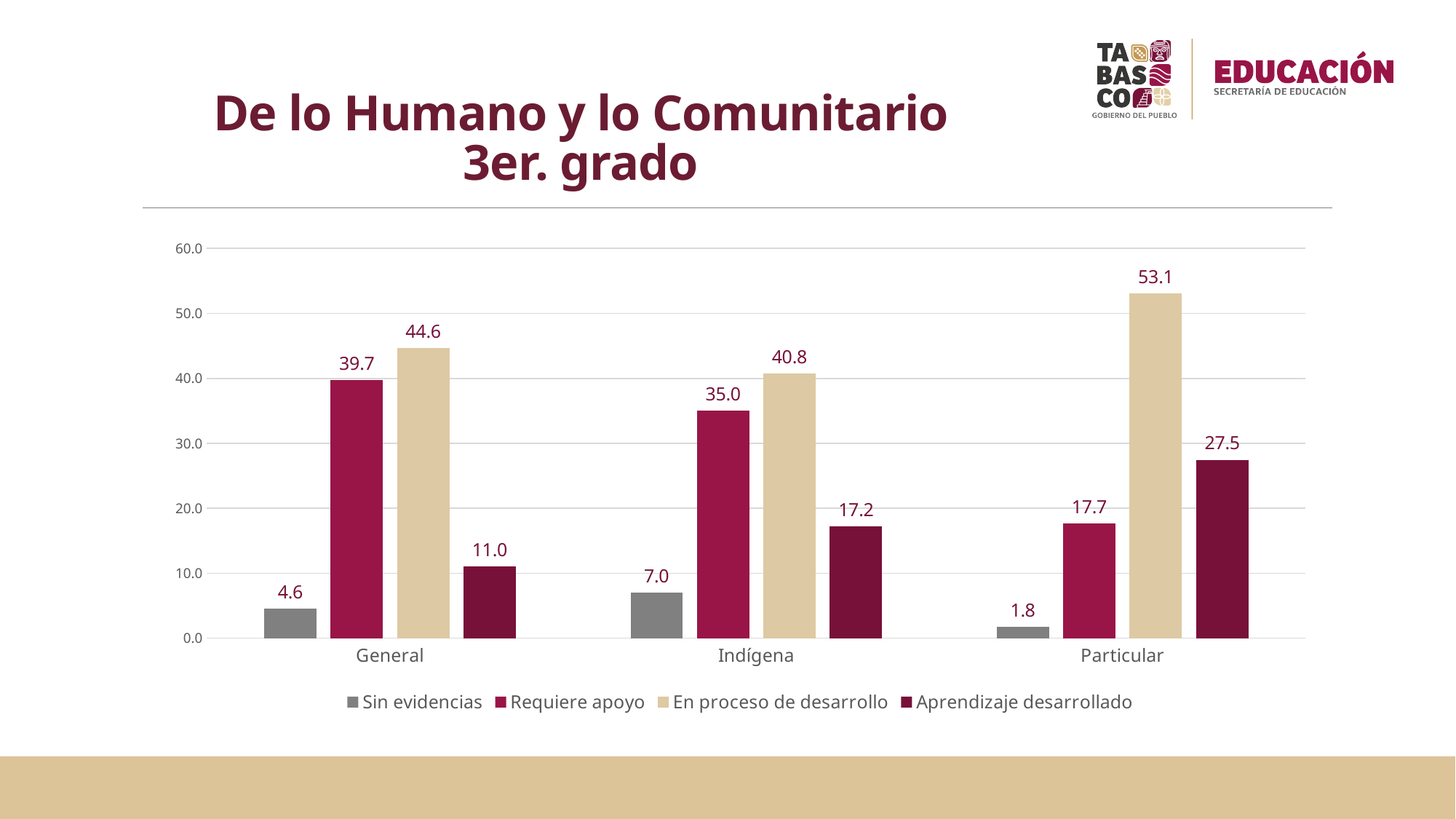
Which category has the highest value for "Requiere apoyo"? General Is the value for "En proceso de desarrollo" in the General category greater or less than 40.0? greater Which is larger: "Aprendizaje desarrollado" for Particular or for Indígena? Particular What kind of chart is shown on the slide? Bar chart What is the value for "Aprendizaje desarrollado" in the General category? 11.0 Which category has the lowest value for "Sin evidencias"? Particular What is the value for "En proceso de desarrollo" in the Particular category? 53.1 What is the title of the slide? De lo Humano y lo Comunitario 3er. grado What is the value for "Sin evidencias" in the Indígena category? 7.0 How many categories are shown on the x axis? 3 What is the difference between "En proceso de desarrollo" and "Requiere apoyo" in the Indígena category? 5.8 How many series does the legend list? 4